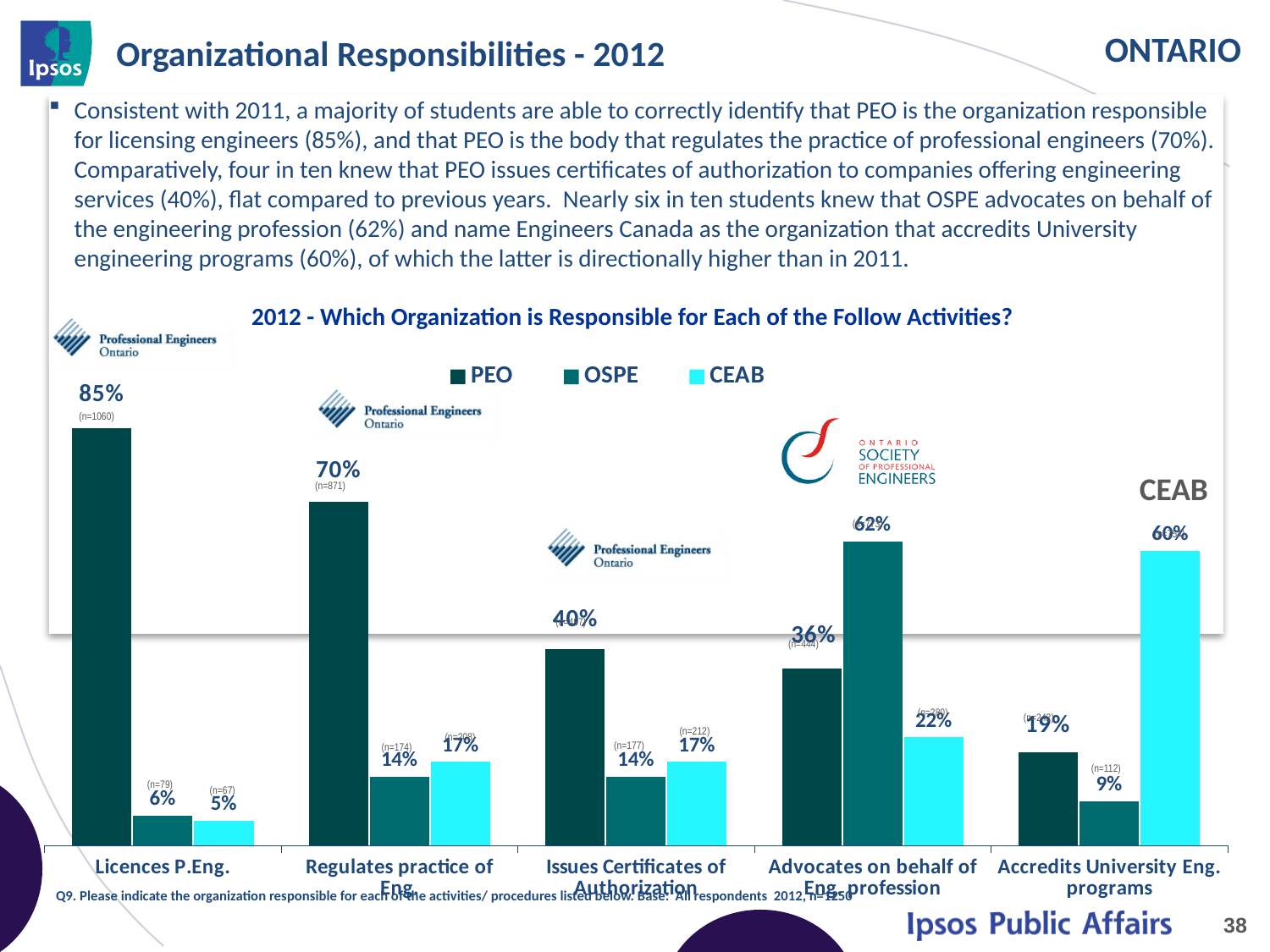
How many activity categories are shown on the x axis? 5 What kind of chart is shown on the slide? Bar chart What is the PEO value for 'Issues Certificates of Authorization'? 40% How many series does the legend list? 3 For 'Advocates on behalf of Eng. profession', which is larger: the PEO value or the OSPE value? OSPE What is the title of the chart? 2012 - Which Organization is Responsible for Each of the Follow Activities? What is the difference between the PEO values for 'Licences P.Eng.' and 'Regulates practice of Eng.'? 15% Which category has the lowest CEAB value? Licences P.Eng. What is the OSPE value for 'Advocates on behalf of Eng. profession'? 62% What percentage of students identified PEO as responsible for Licences P.Eng.? 85% Which category has the highest PEO value? Licences P.Eng. What is the CEAB value for 'Accredits University Eng. programs'? 60%